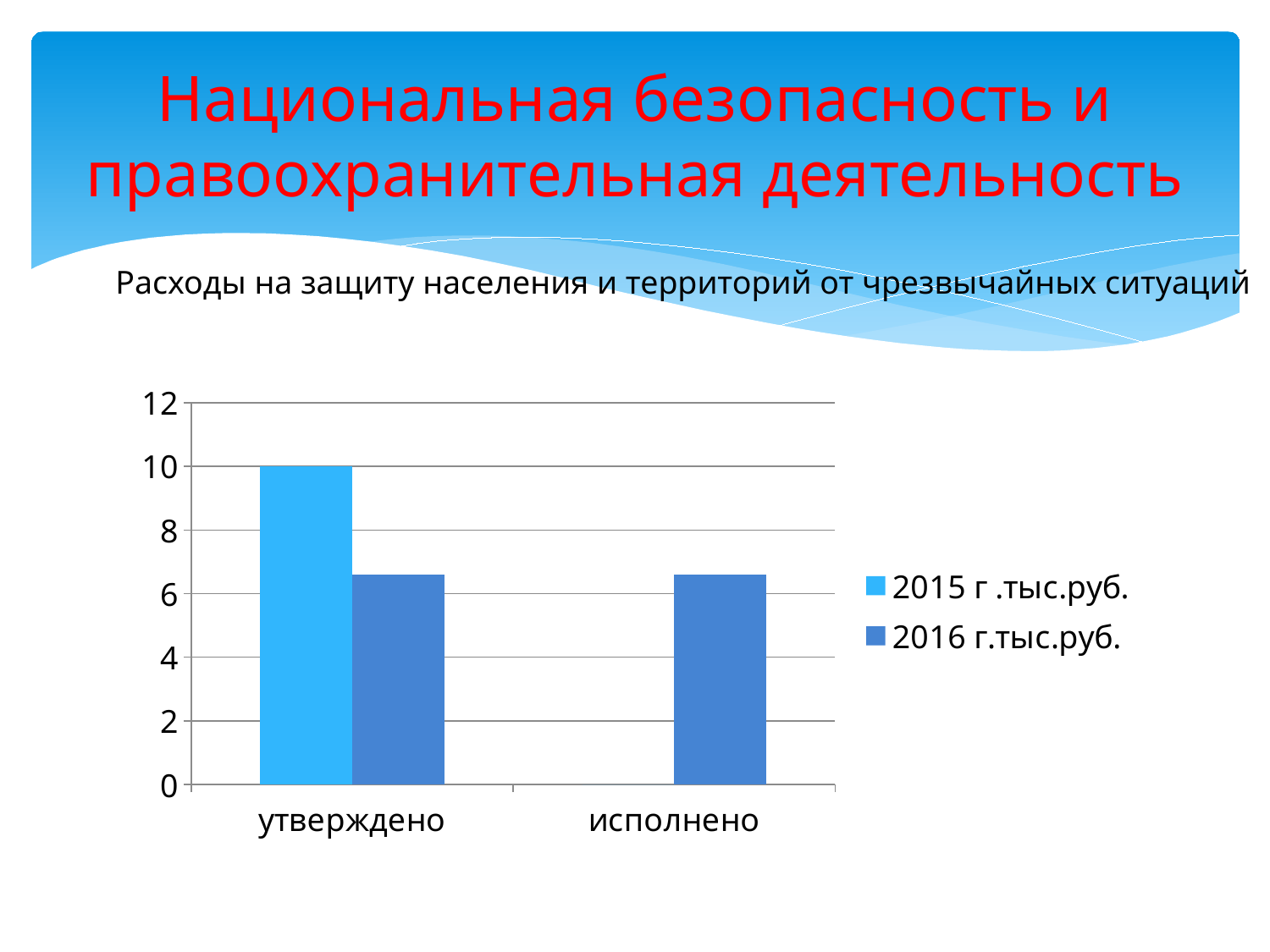
Which category has the highest bar in the chart? утверждено What is the value for 2015 г .тыс.руб. in the утверждено category? 10 What kind of chart is shown on the slide? bar chart Is the value for 2016 г.тыс.руб. in the утверждено category greater or less than 6? greater Is the value for 2016 г.тыс.руб. in the исполнено category greater or less than 6? greater How many categories are shown on the x axis of the chart? 2 Is the value for 2016 г.тыс.руб. in the утверждено category greater or less than 8? less What are the two entries listed in the chart legend? 2015 г .тыс.руб. and 2016 г.тыс.руб. In the утверждено category, which series has the larger value, 2015 г .тыс.руб. or 2016 г.тыс.руб.? 2015 г .тыс.руб. How many series does the chart legend list? 2 What is the subtitle describing the chart on the slide? Расходы на защиту населения и территорий от чрезвычайных ситуаций